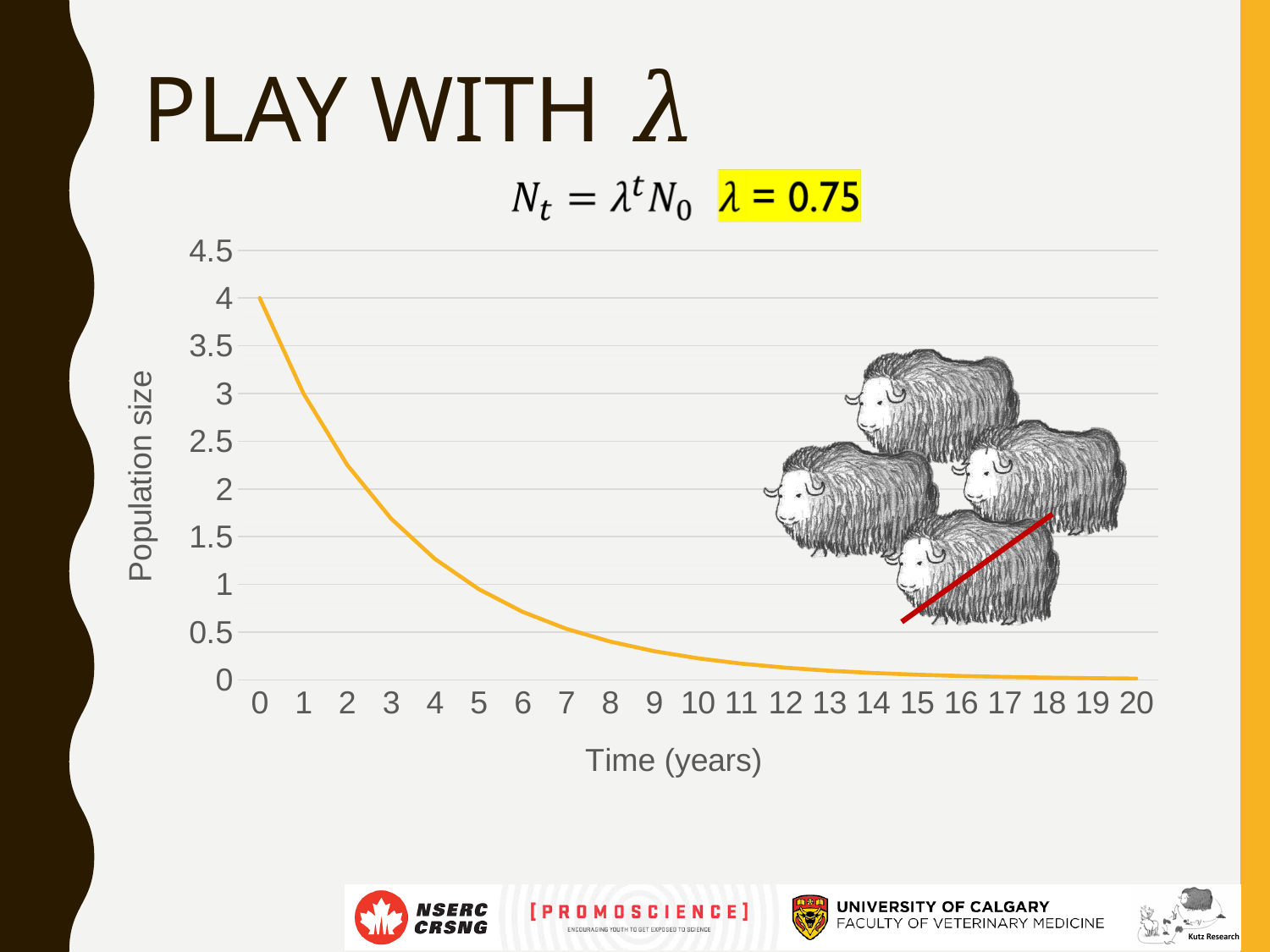
What value of λ is highlighted above the chart? 0.75 What is the label of the x axis? Time (years) What is the population size at time 0 years? 4 Which is larger, the population size at 2 years or at 8 years? 2 years Does the population size rise or fall as time increases along the x axis? fall At which time (in years) is the population size lowest? 20 What is the population size at time 1 year? 3 Is the population size at 10 years greater or less than 0.5? less Is the population size at 2 years greater or less than 2? greater At which time (in years) is the population size highest? 0 What type of chart is shown on the slide? line chart